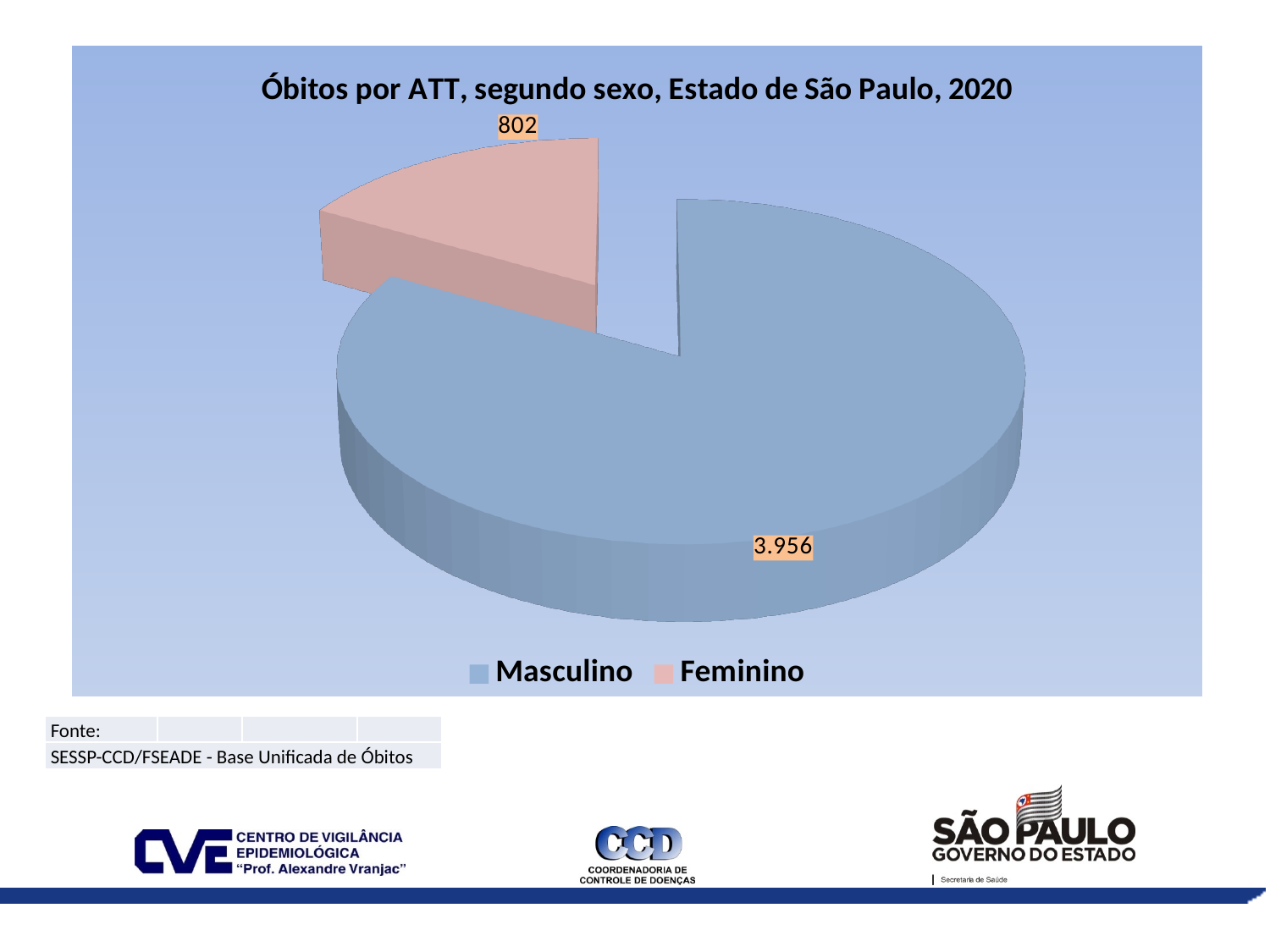
What is the difference between the Masculino and Feminino values? 3.154 What is the title of the chart? Óbitos por ATT, segundo sexo, Estado de São Paulo, 2020 Which category has the smallest slice of the pie? Feminino Which colour represents Feminino in the pie chart? Pink What is the value for Feminino in the pie chart? 802 How many categories are shown in the pie chart? 2 Which is larger, the value for Masculino or the value for Feminino? Masculino What type of chart is shown on the slide? Pie chart What is the total of the two slices in the pie chart? 4.758 What share of the pie does the Feminino slice represent? 16.9% Which category has the largest slice of the pie? Masculino What is the value for Masculino in the pie chart? 3.956